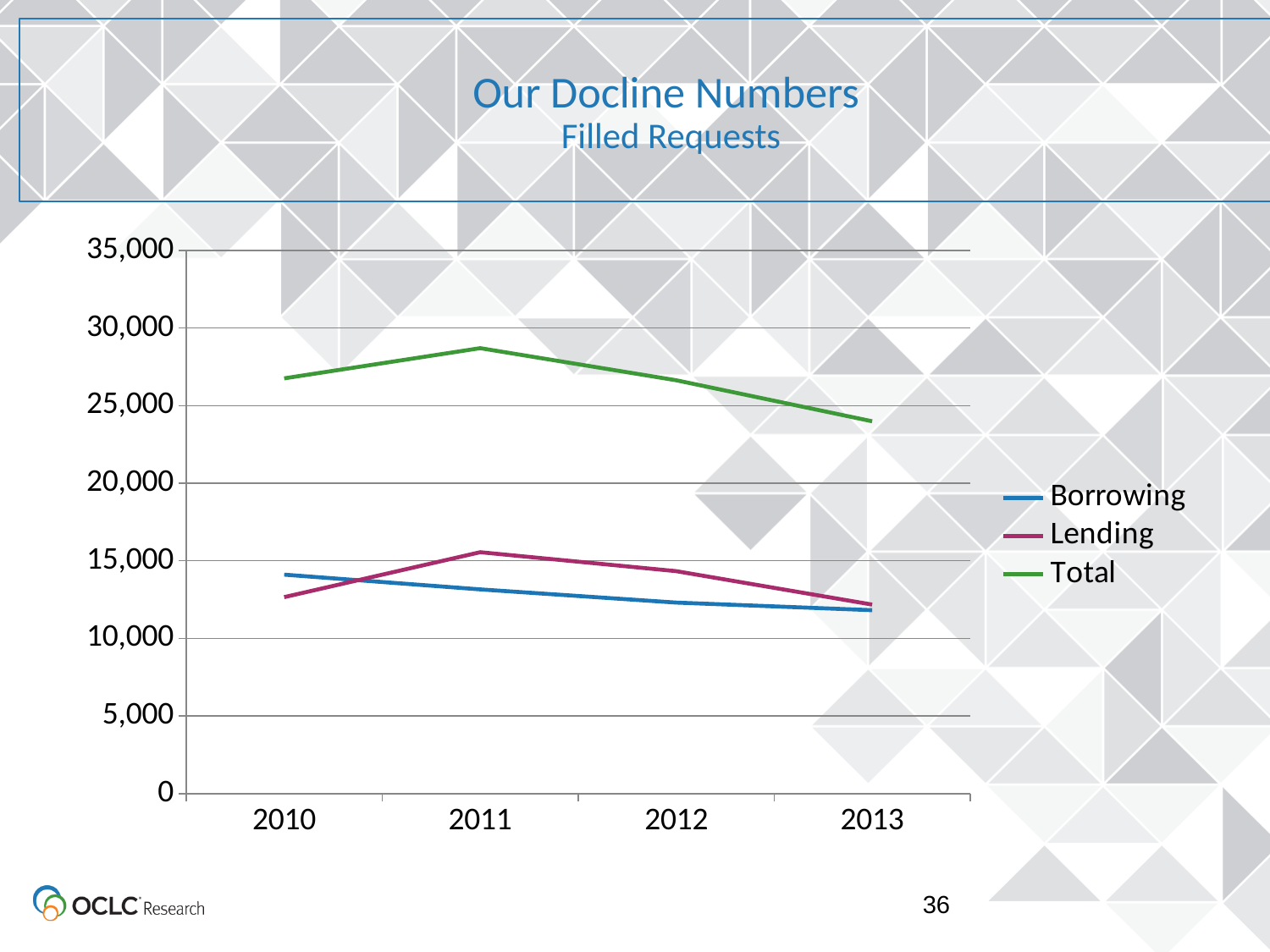
What kind of chart is shown on the slide? Line chart In which year is the Borrowing line at its highest? 2010 How many series does the legend list? 3 In which year is the Total line at its lowest? 2013 In 2010, which is larger, Borrowing or Lending? Borrowing In which year is the Total line at its highest? 2011 Is the Borrowing value for 2010 greater or less than 15,000? less How many years are shown on the x axis? 4 Is the Total value for 2011 greater or less than 25,000? greater Is the Total value for 2013 greater or less than 25,000? less In 2011, which is larger, Borrowing or Lending? Lending Does the Borrowing line rise or fall from 2010 to 2013? Falls